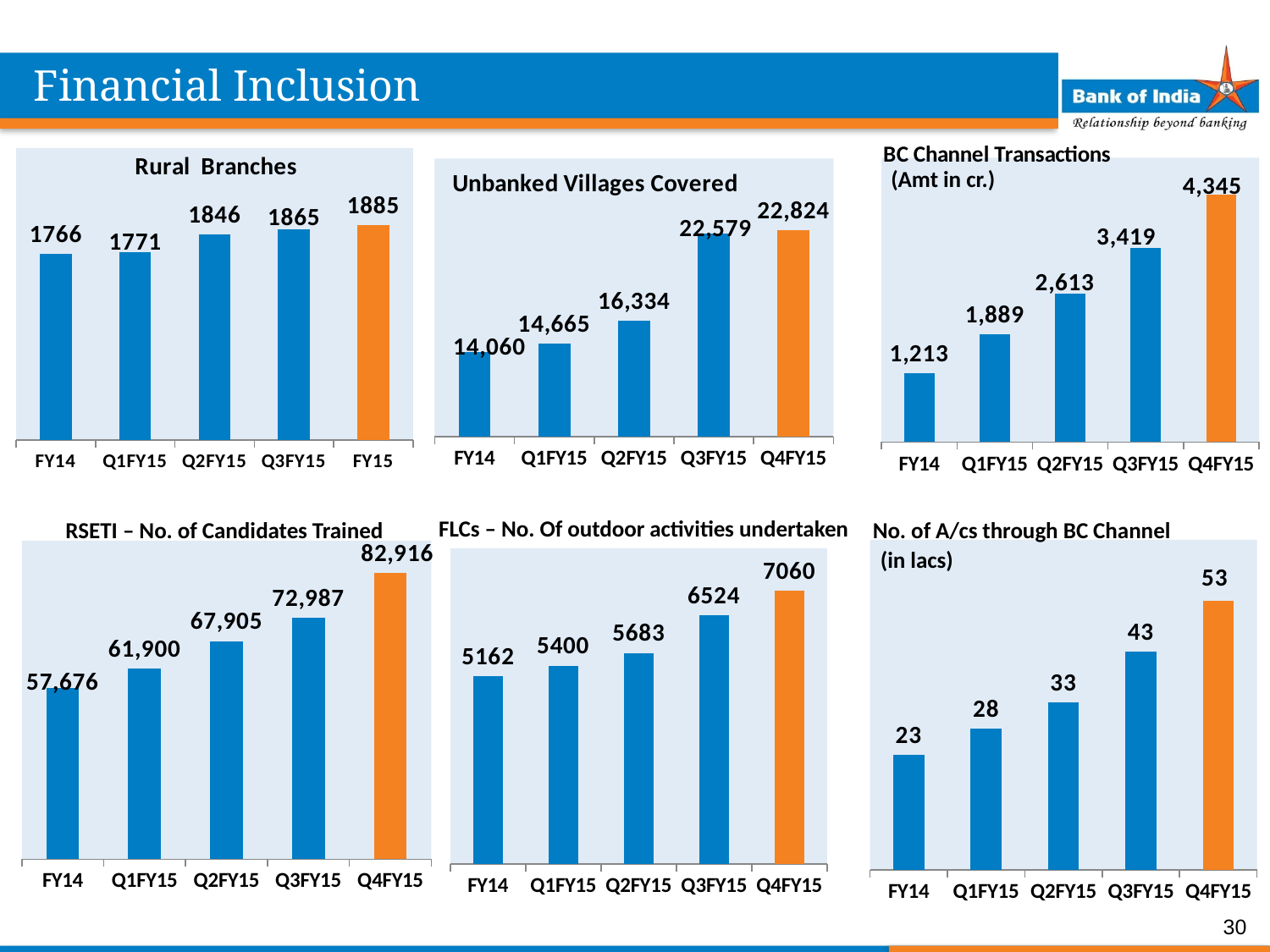
In the RSETI – No. of Candidates Trained chart, what is the value for Q1FY15? 61,900 What kind of chart is the Rural Branches chart? bar chart In the Unbanked Villages Covered chart, what is the value for Q4FY15? 22,824 In the No. of A/cs through BC Channel (in lacs) chart, what is the value for Q2FY15? 33 In the BC Channel Transactions (Amt in cr.) chart, what is the difference between Q4FY15 and Q3FY15? 926 In the FLCs – No. Of outdoor activities undertaken chart, which is larger, Q1FY15 or FY14? Q1FY15 In the BC Channel Transactions (Amt in cr.) chart, which period has the lowest value? FY14 How many bars are plotted in the Unbanked Villages Covered chart? 5 In the No. of A/cs through BC Channel (in lacs) chart, do the values rise or fall from FY14 to Q4FY15? rise In the RSETI – No. of Candidates Trained chart, which period has the highest value? Q4FY15 In the FLCs – No. Of outdoor activities undertaken chart, what is the difference between Q3FY15 and Q2FY15? 841 In the Rural Branches chart, what is the value for Q2FY15? 1846